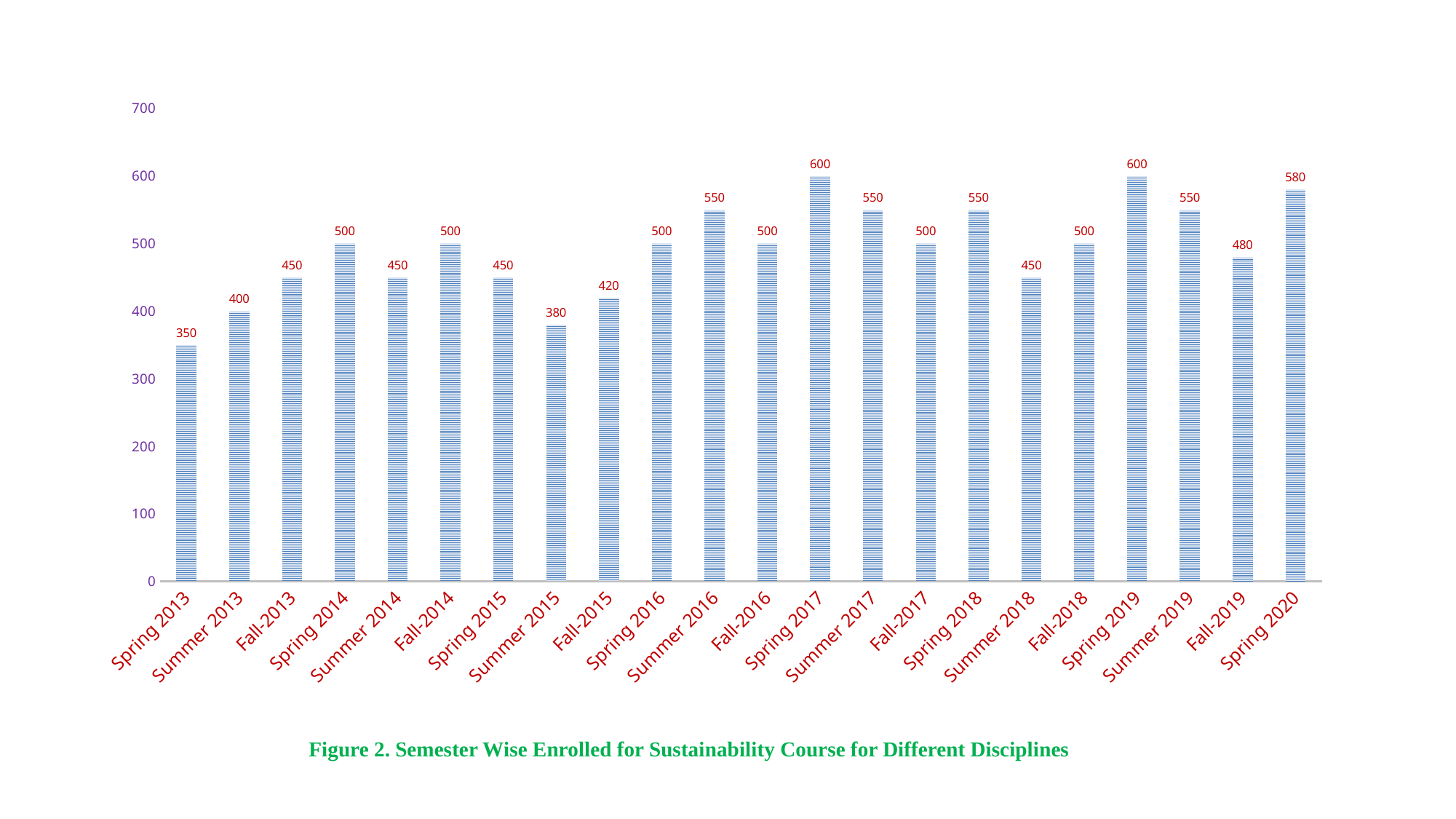
Is the value for Summer 2013 greater or less than 500? less What is the value for Fall-2019? 480 What is the difference between the values for Spring 2017 and Summer 2018? 150 How many semesters are shown on the chart? 22 What kind of chart is shown on the slide? bar chart What is the value for Summer 2015? 380 What is the value for Spring 2020? 580 Which is larger, the value for Fall-2015 or the value for Summer 2016? Summer 2016 Which semester has the lowest value? Spring 2013 What is the value for Spring 2013? 350 What is the highest value shown on the chart? 600 What is the figure caption below the chart? Figure 2. Semester Wise Enrolled for Sustainability Course for Different Disciplines